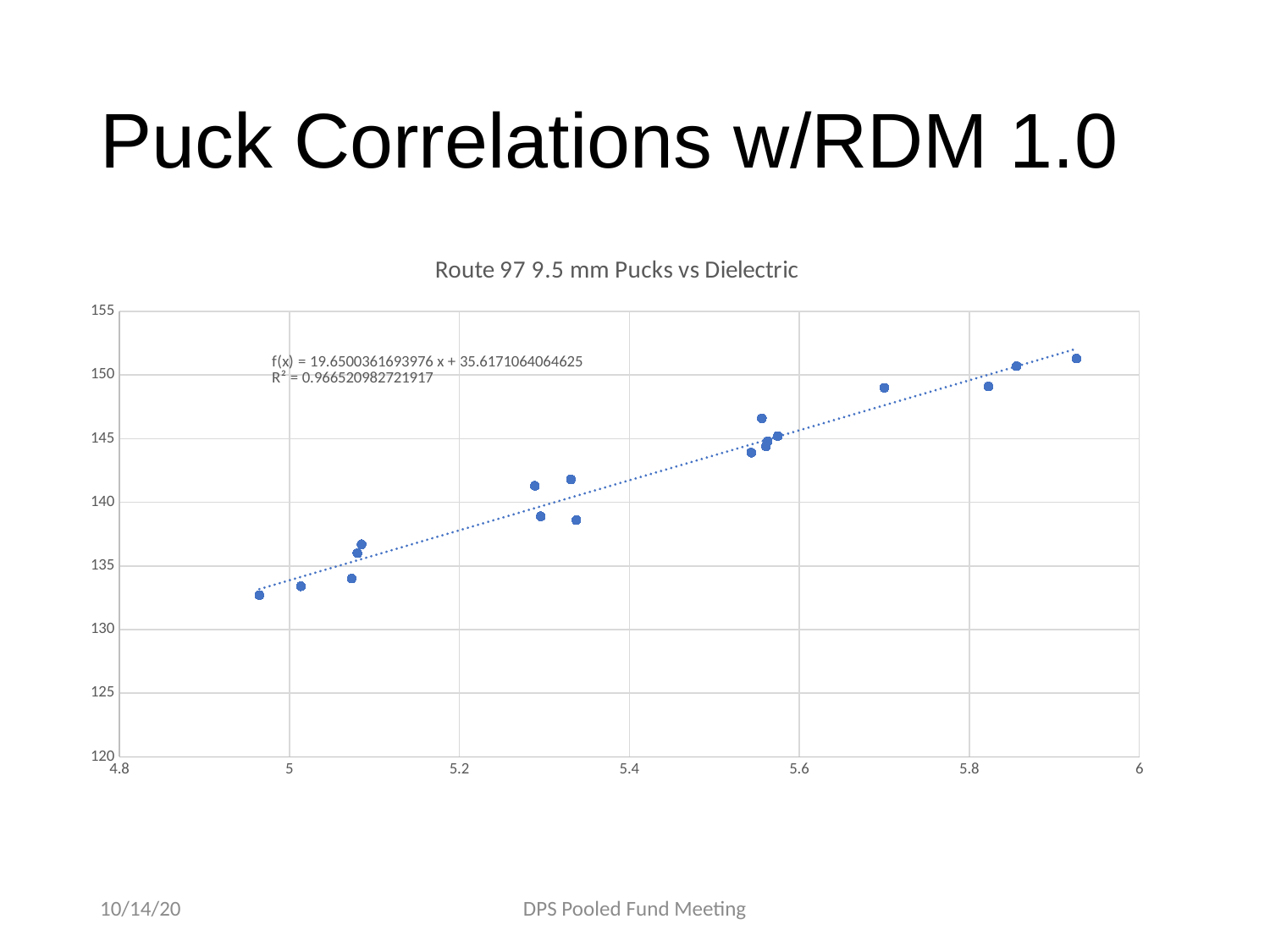
Is the y value of the point near x = 5.55 with the highest y greater or less than 145? greater Do the plotted values rise or fall as the x-axis value increases? rise Is the y value of the leftmost point (near x = 4.97) greater or less than 135? less Is the y value of the highest point near x = 5.3 greater or less than 140? greater What is the title of the chart? Route 97 9.5 mm Pucks vs Dielectric What is the R² value shown on the chart? R² = 0.966520982721917 What is the lowest value shown on the y-axis? 120 What is the trendline equation shown on the chart? f(x) = 19.6500361693976 x + 35.6171064064625 Which has the larger y value: the point near x = 5.7 or the point near x = 5.0? the point near x = 5.7 What kind of chart is shown on the slide? scatter chart